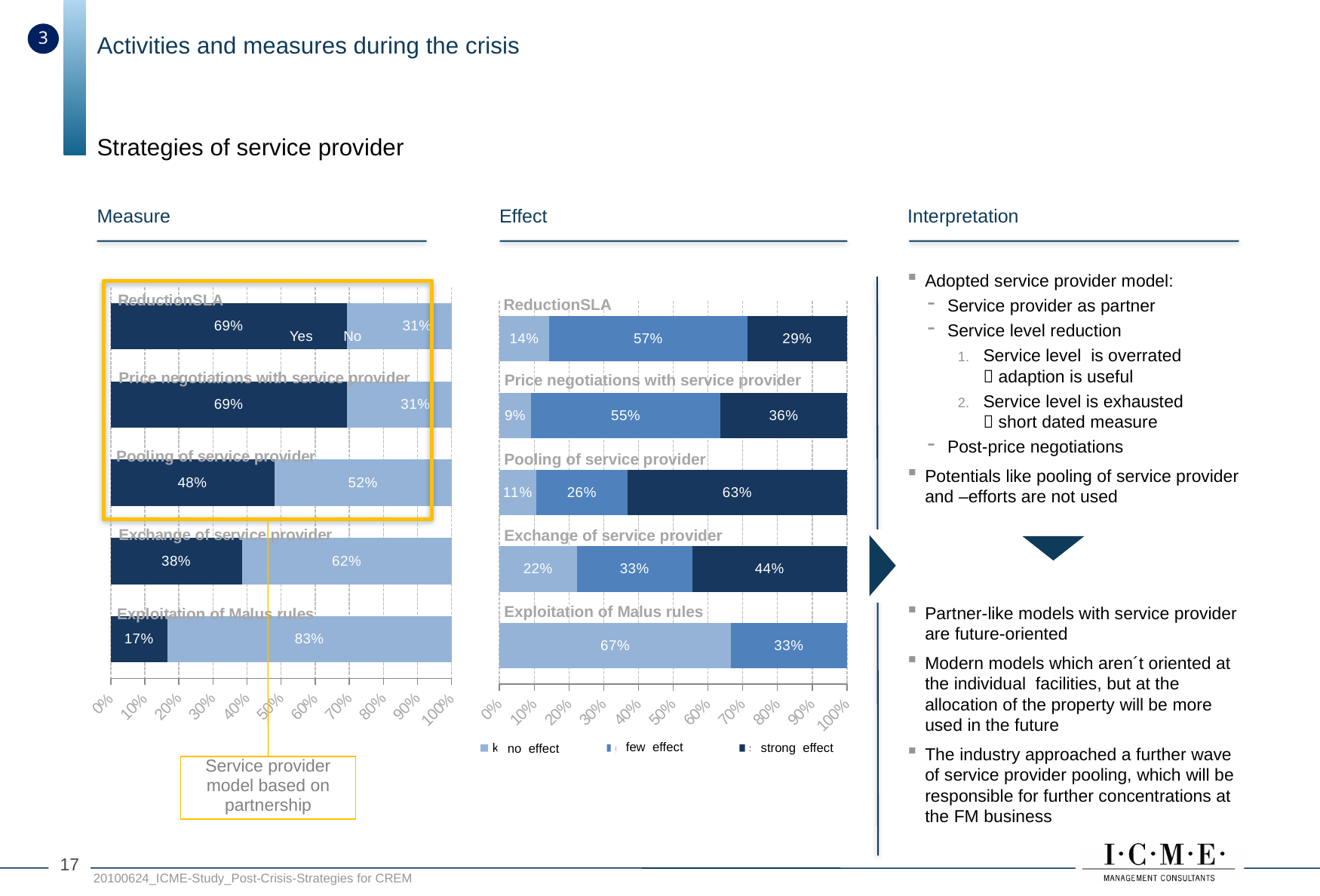
In the Measure chart, which measure has the lowest Yes share? Exploitation of Malus rules In the Effect chart, which measure has the highest strong effect value? Pooling of service provider In the Effect chart, is the strong effect value for Exchange of service provider larger or smaller than that for Price negotiations with service provider? larger In the Measure chart, what is the difference between the No value and the Yes value for Exchange of service provider? 24% How many series does the legend of the Effect chart list? 3 What type of chart is the Measure chart? Stacked bar chart In the Effect chart, what is the no effect value for Price negotiations with service provider? 9% In the Measure chart, which measure has the highest Yes share? ReductionSLA and Price negotiations with service provider (69%) In the Effect chart, what is the few effect value for ReductionSLA? 57% In the Measure chart, what is the Yes value for Exploitation of Malus rules? 17% In the Measure chart, what is the No value for Pooling of service provider? 52% In the Effect chart, what is the strong effect value for Pooling of service provider? 63%